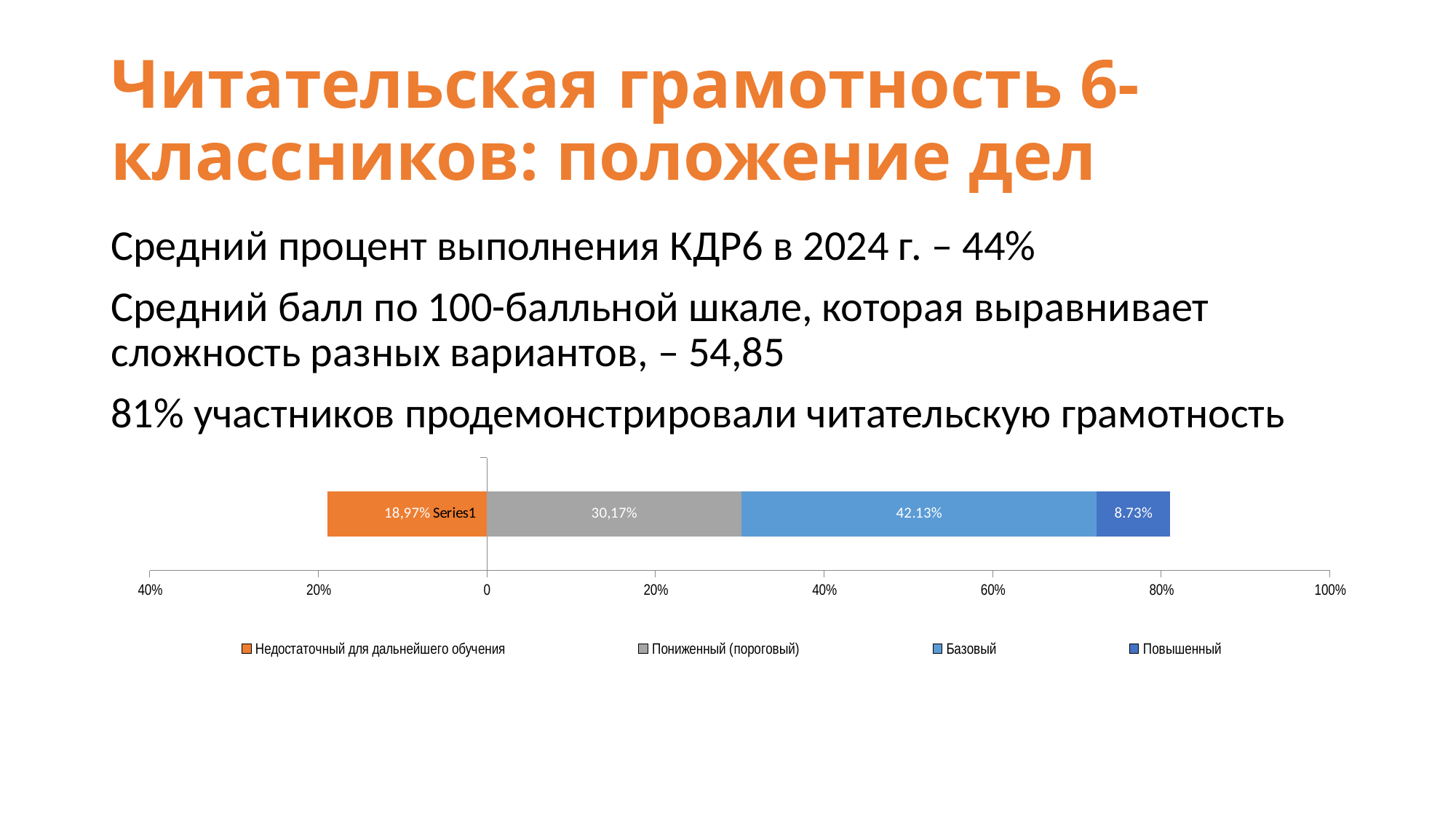
What is the difference between the 'Базовый' share and the 'Повышенный' share? 33.40% What value is shown for the segment 'Повышенный'? 8.73% What kind of chart is shown on the slide? Stacked bar chart What value is shown for the segment 'Пониженный (пороговый)'? 30,17% How many series does the legend list? 4 Which level has the smallest share in the bar? Повышенный What value is shown for the segment 'Базовый'? 42.13% Which colour represents 'Повышенный' in the legend? Dark blue What value is shown for the segment 'Недостаточный для дальнейшего обучения'? 18,97% Which level has the largest share in the bar? Базовый Which is larger: the share for 'Пониженный (пороговый)' or for 'Недостаточный для дальнейшего обучения'? Пониженный (пороговый) What is the category label printed on the bar? Series1